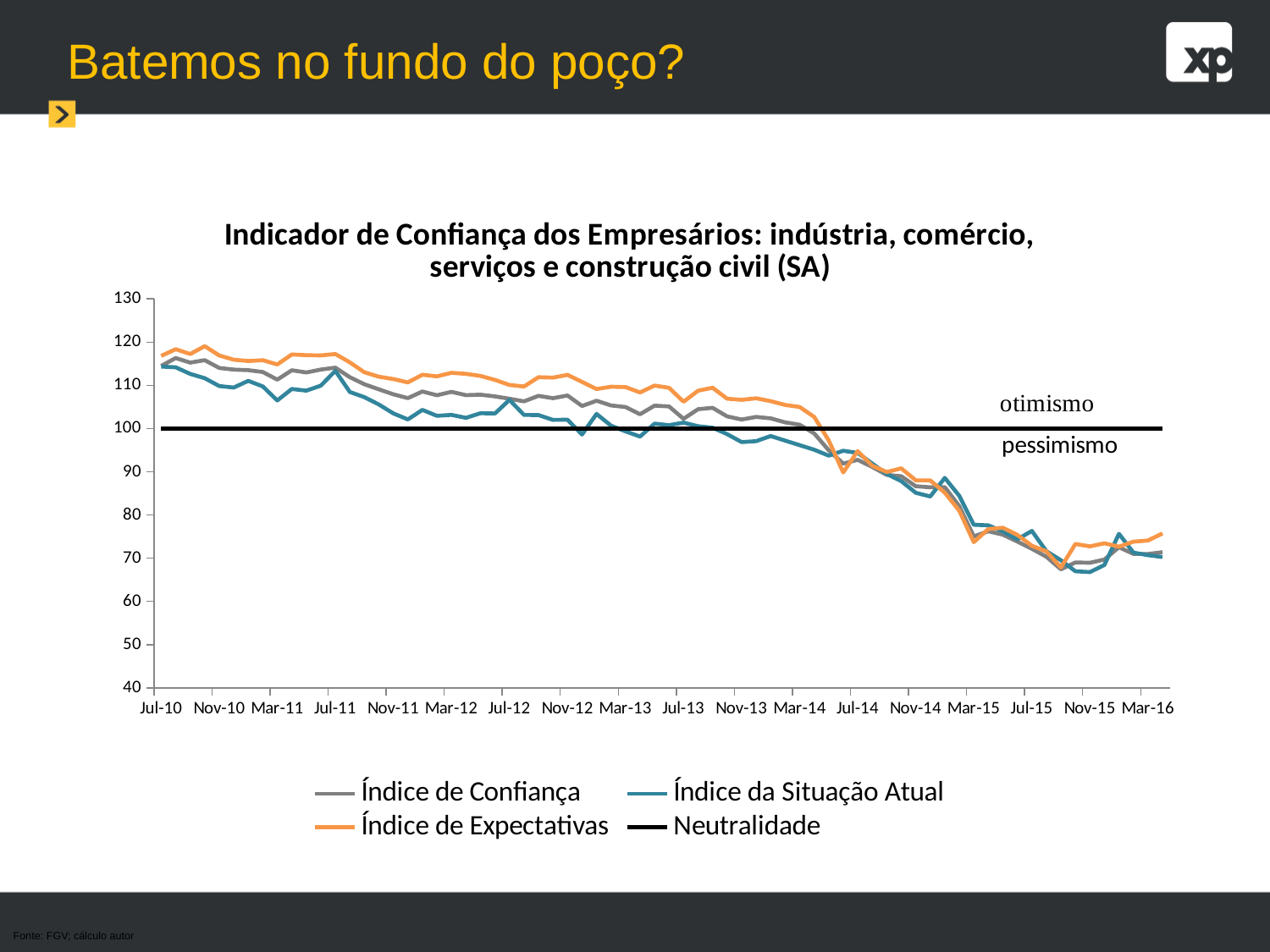
Is the value of Índice de Confiança at Jul-14 greater or less than 100? less At Nov-11, which is larger: Índice de Expectativas or Índice da Situação Atual? Índice de Expectativas How many date labels are shown on the x axis? 18 How many series does the legend list? 4 Is the value of Índice de Expectativas at Jul-10 greater or less than 110? greater Is the value of Índice da Situação Atual at Nov-15 greater or less than 70? less At what value is the Neutralidade line drawn? 100 Which label appears above the Neutralidade line on the right side of the chart? otimismo What is the title of the chart? Indicador de Confiança dos Empresários: indústria, comércio, serviços e construção civil (SA) What kind of chart is shown on the slide? line chart Overall, do the Índice de Confiança values rise or fall from Jul-10 to Mar-16? fall